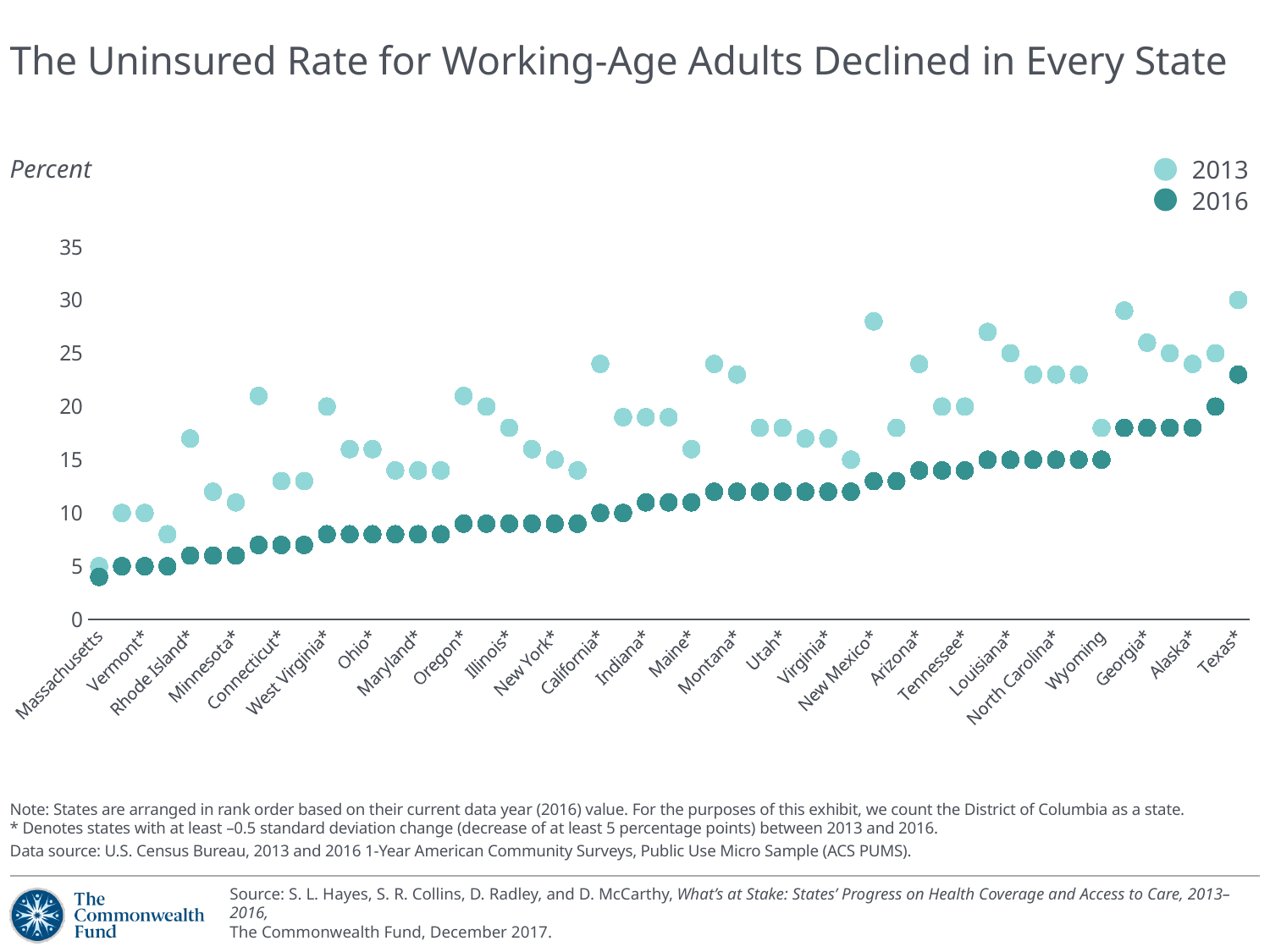
What kind of chart is shown on the slide? Dot (scatter) chart Is the 2016 value for Texas greater or less than 20? greater Do the 2016 values rise or fall moving from left to right along the x axis? rise How many series does the legend list? 2 Is the 2013 value for West Virginia greater or less than 15? greater Is the 2013 value for Texas greater or less than 25? greater Which state has the lowest 2016 uninsured rate? Massachusetts Which is larger, the 2013 value for California or the 2013 value for Ohio? California Which state has the highest 2013 uninsured rate? Texas Which two years are shown in the legend? 2013 and 2016